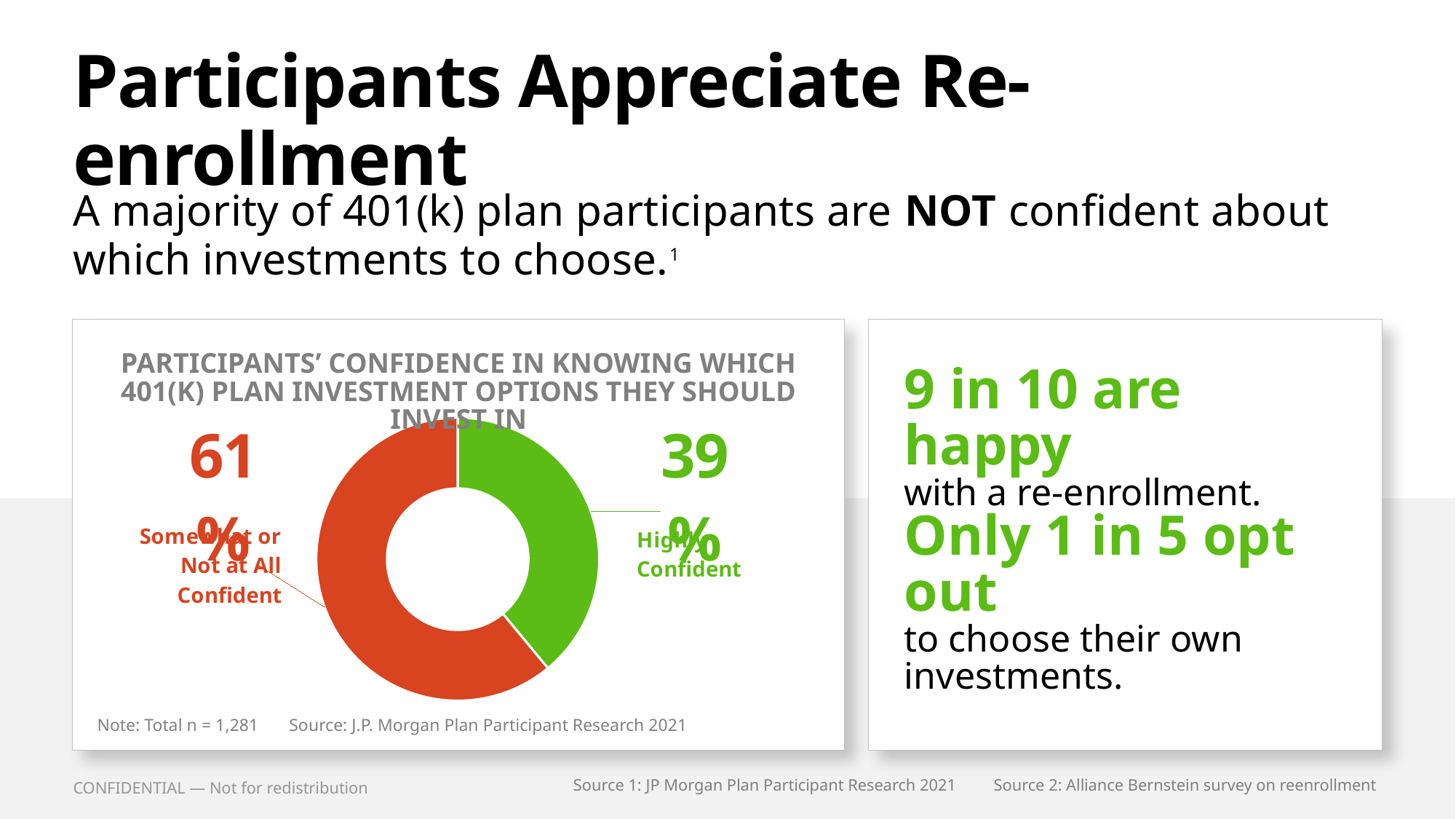
What percentage of participants are Somewhat or Not at All Confident? 61% Which category has the smaller share of the donut chart? Highly Confident How many categories are shown in the donut chart? 2 Which category has the larger share of the donut chart? Somewhat or Not at All Confident What is the title of the chart? Participants' Confidence in Knowing Which 401(k) Plan Investment Options They Should Invest In What is the total of the two slices in the donut chart? 100% What colour is the Highly Confident slice of the donut chart? green What percentage of participants are Highly Confident? 39% Is the share for Highly Confident larger or smaller than the share for Somewhat or Not at All Confident? smaller What is the difference in percentage points between Somewhat or Not at All Confident and Highly Confident? 22 What is the total sample size (n) noted below the chart? 1,281 What kind of chart is shown on the slide? donut (pie) chart